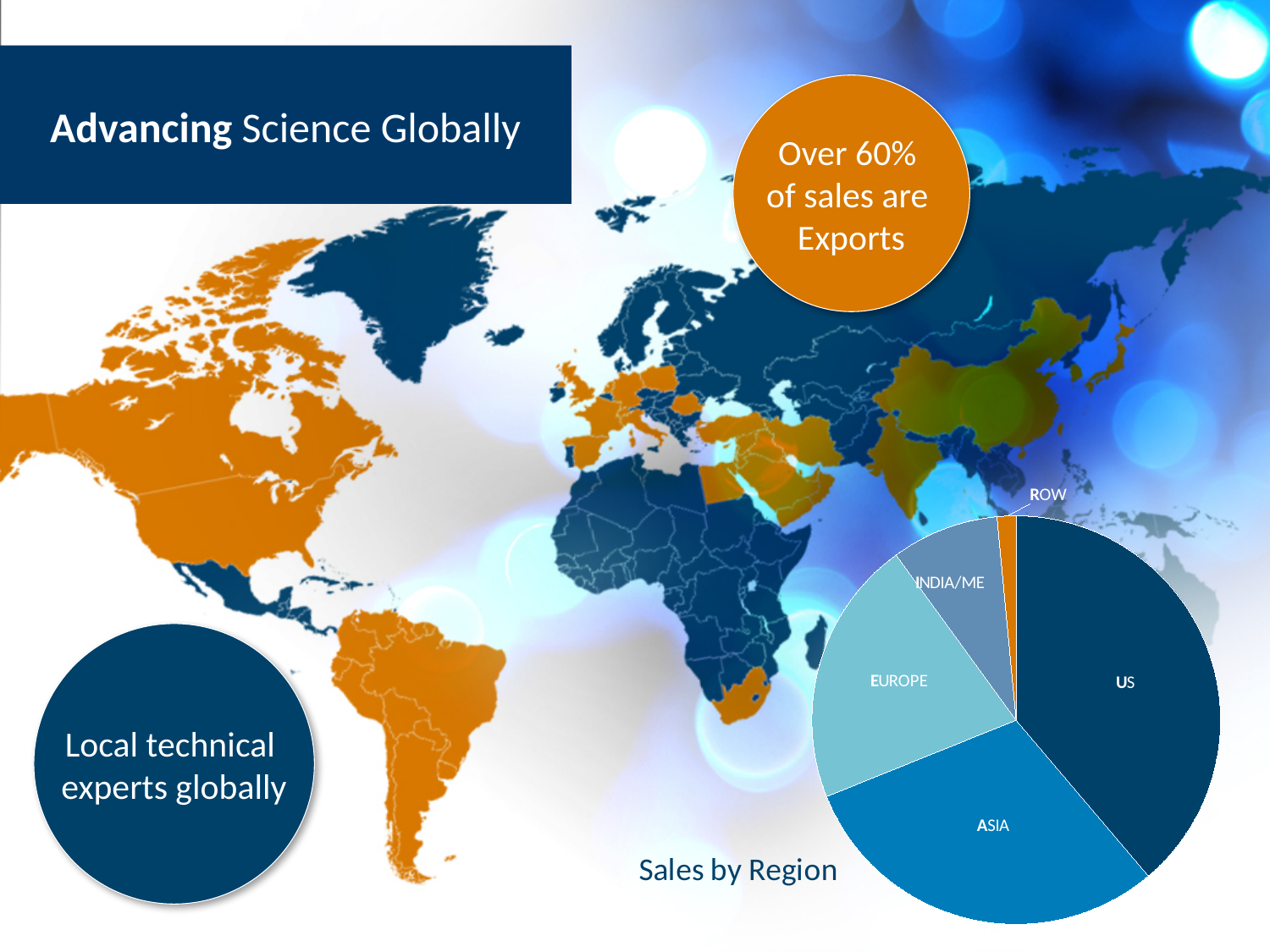
What kind of chart is the Sales by Region chart? pie chart Which region has the largest slice in the Sales by Region pie chart? US How many regions are shown as slices in the Sales by Region pie chart? 5 In the Sales by Region pie chart, which slice is larger, INDIA/ME or ROW? INDIA/ME In the Sales by Region pie chart, which slice is larger, ASIA or EUROPE? ASIA Which slice in the Sales by Region pie chart is coloured orange? ROW In the Sales by Region pie chart, which slice is larger, US or ASIA? US What is the title of the pie chart on the slide? Sales by Region Which region has the smallest slice in the Sales by Region pie chart? ROW